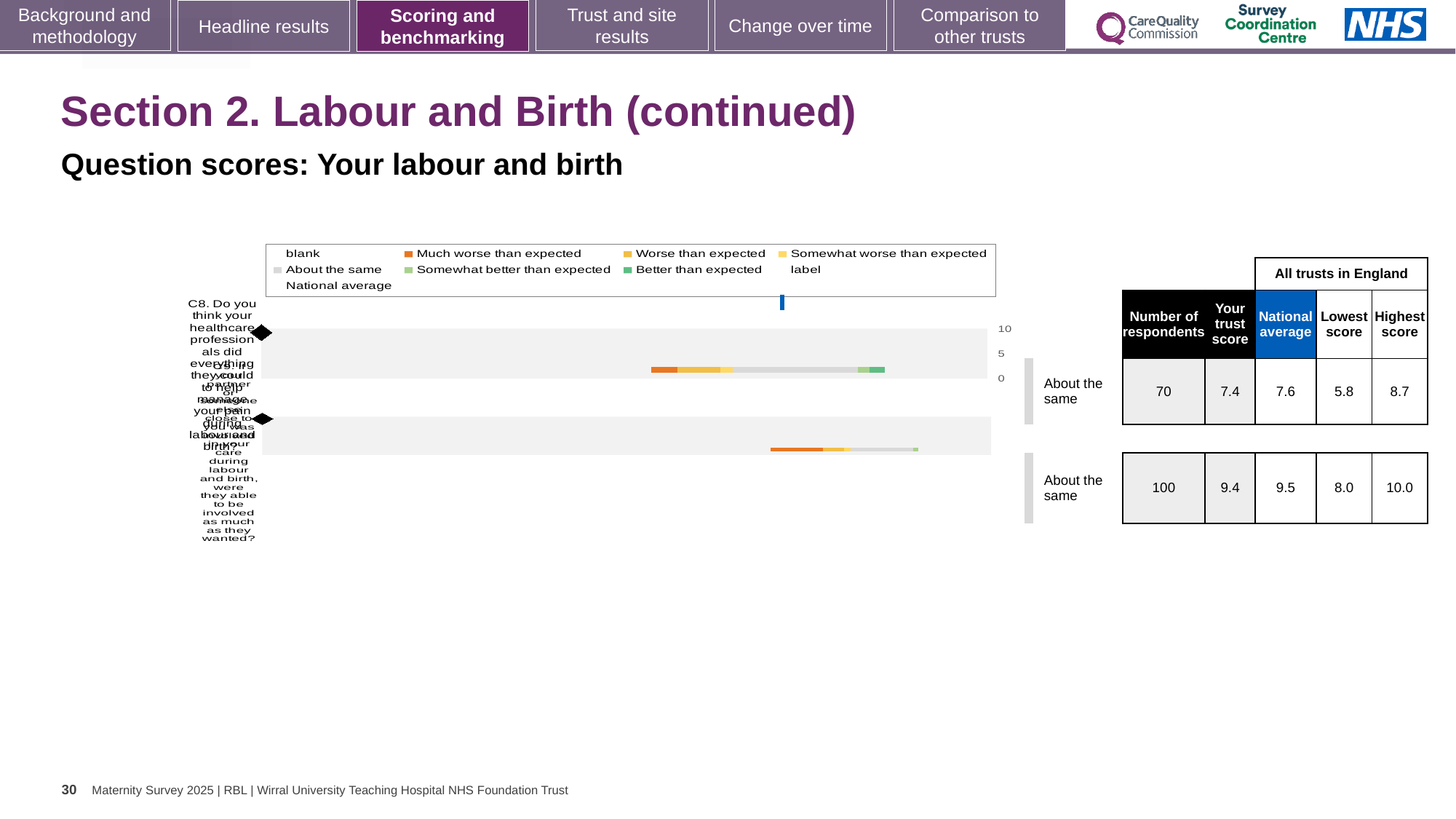
How many question rows are plotted in the chart? 2 In the table beside the chart, what is the national average for the first row (question C8)? 7.6 For the first row (question C8), which is larger: the trust score or the national average? National average In the table beside the chart, what is the trust score for the first row (question C8)? 7.4 For the first row (question C8), what is the difference between the highest score and the lowest score? 2.9 What benchmark category is shown for both rows in the chart? About the same In the table beside the chart, what is the lowest score for the second row? 8.0 In the table beside the chart, what is the highest score for the second row? 10.0 What colour does the legend use for 'Much worse than expected'? Orange What kind of chart is shown on the slide? bar chart In the table beside the chart, what is the number of respondents for the first row (question C8)? 70 In the table beside the chart, what is the number of respondents for the second row? 100